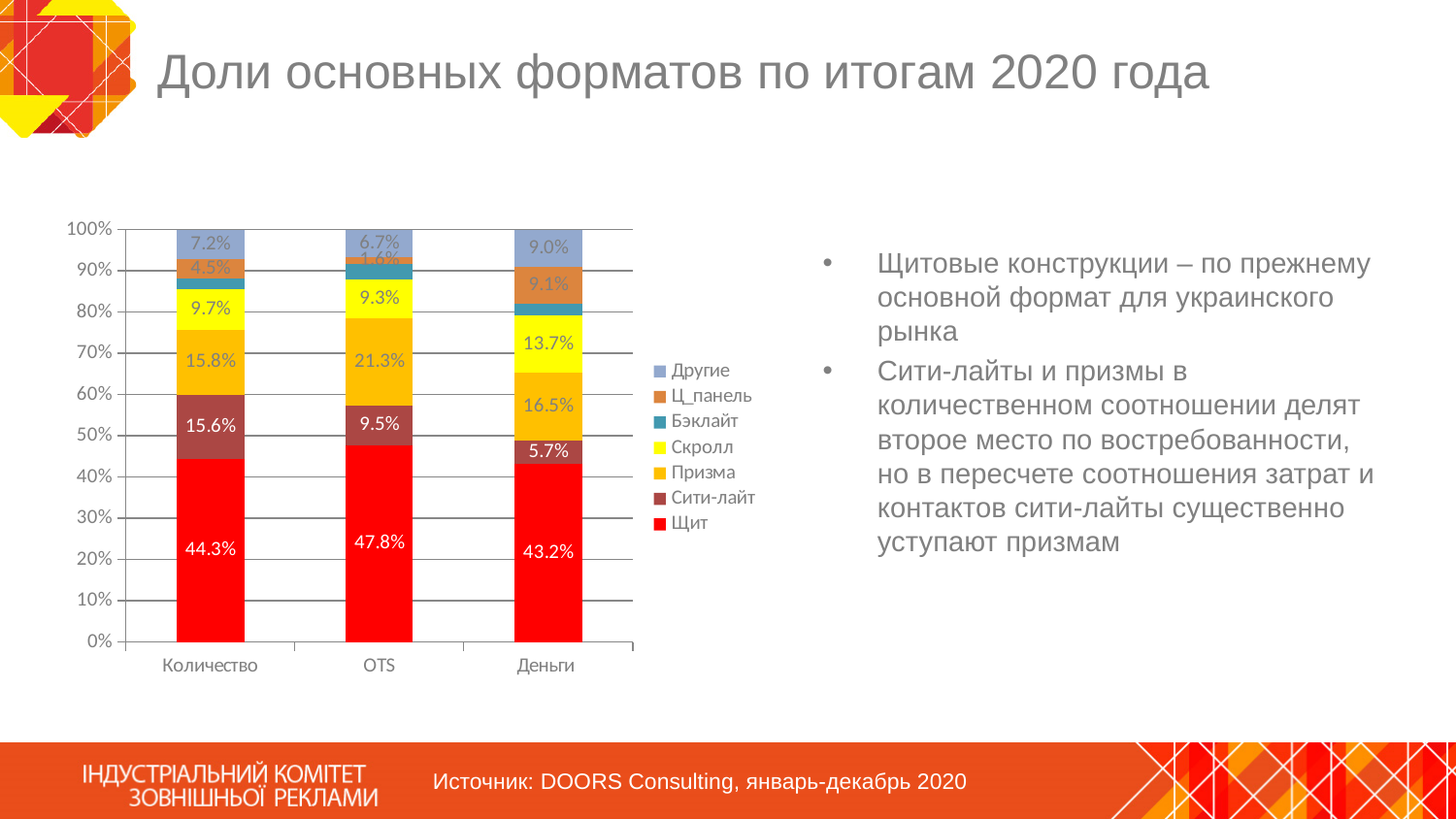
What is the value of Щит for Количество? 44.3% Which category has the lowest value for Сити-лайт? Деньги How many categories are shown on the x axis? 3 Which category has the highest value for Щит? OTS How many series does the legend list? 7 What is the value of Щит for OTS? 47.8% What type of chart is shown on the slide? stacked bar chart What is the value of Сити-лайт for Деньги? 5.7% What is the difference between the Призма values for OTS and Количество? 5.5% What is the value of Скролл for OTS? 9.3% Which is larger, Скролл for Деньги or Скролл for Количество? Скролл for Деньги What is the value of Призма for Деньги? 16.5%